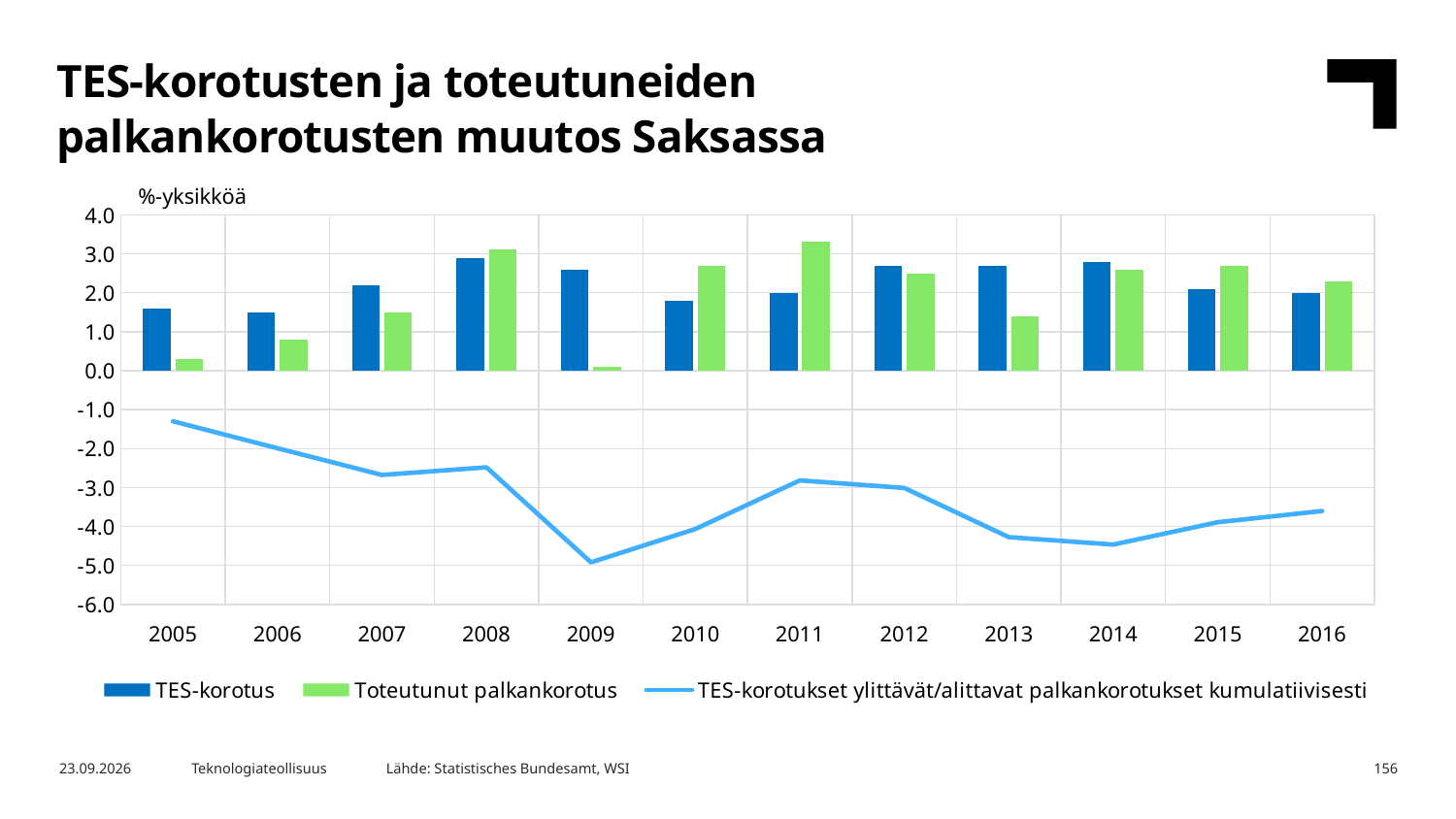
What unit label is shown above the vertical axis? %-yksikköä Is the TES-korotus value for 2008 greater or less than 2.0? greater Is the Toteutunut palkankorotus value for 2011 greater or less than 3.0? greater In which year is the Toteutunut palkankorotus bar lowest? 2009 In 2011, which is larger: TES-korotus or Toteutunut palkankorotus? Toteutunut palkankorotus How many series does the legend list? 3 How many years are shown on the x axis? 12 In 2009, which is larger: TES-korotus or Toteutunut palkankorotus? TES-korotus What kind of chart is shown on the slide? A combined bar and line chart In which year is the Toteutunut palkankorotus bar highest? 2011 Does the cumulative line fall or rise from 2005 to 2009? It falls In which year does the line TES-korotukset ylittävät/alittavat palkankorotukset kumulatiivisesti reach its lowest point? 2009